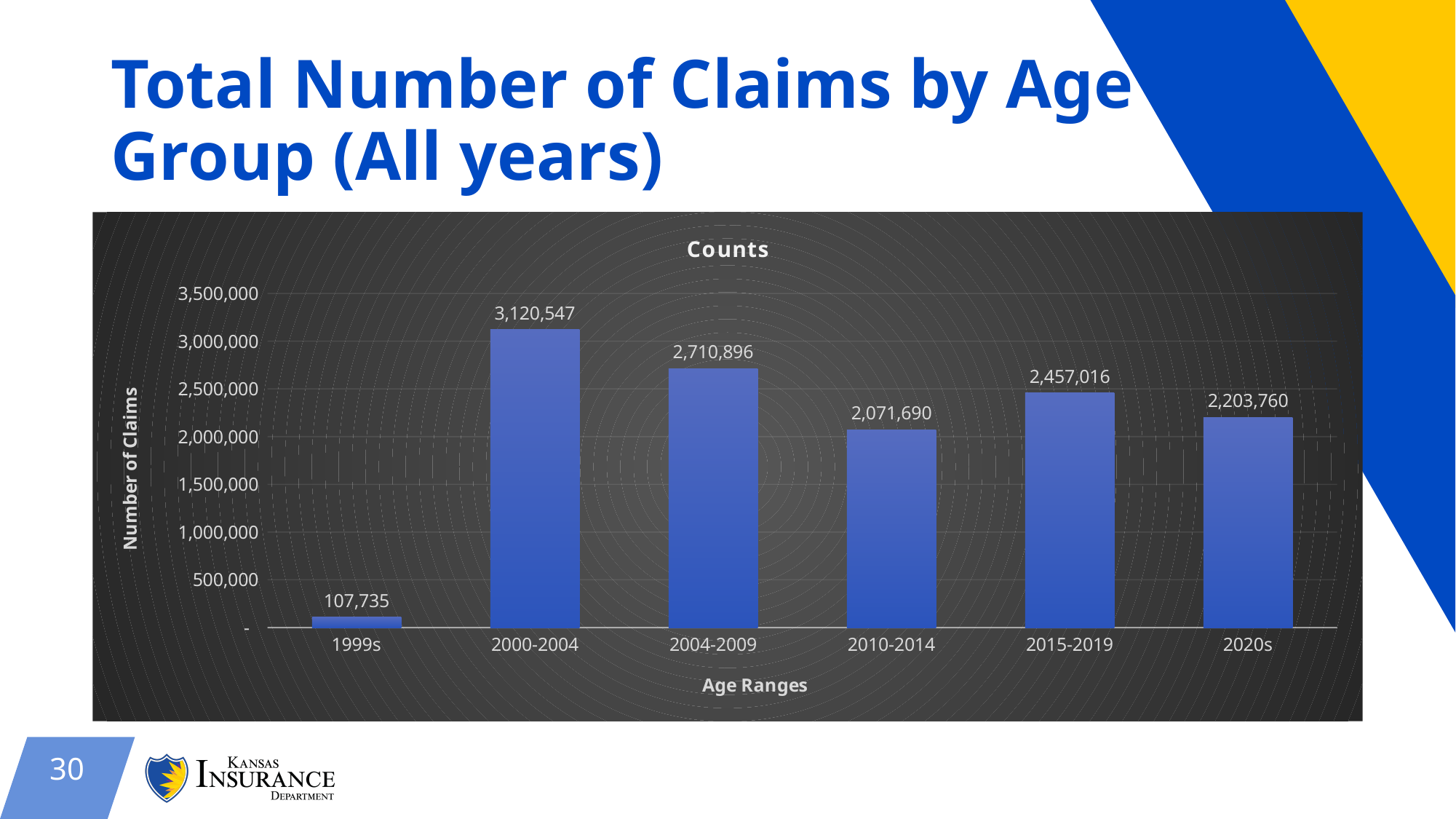
What is the title of the chart's vertical axis? Number of Claims Which age range has the lowest number of claims? 1999s What is the number of claims for the 2000-2004 age range? 3,120,547 What is the difference in claims between the 2015-2019 and 2020s age ranges? 253,256 What is the number of claims for the 2020s age range? 2,203,760 Is the value for the 2004-2009 age range greater or less than 2,500,000? greater What is the number of claims for the 1999s age range? 107,735 What is the difference in claims between the 2000-2004 and 2004-2009 age ranges? 409,651 Which age range has the highest number of claims? 2000-2004 How many age ranges are shown on the chart? 6 Which age range has more claims, 2010-2014 or 2015-2019? 2015-2019 What kind of chart is shown on the slide? Bar chart